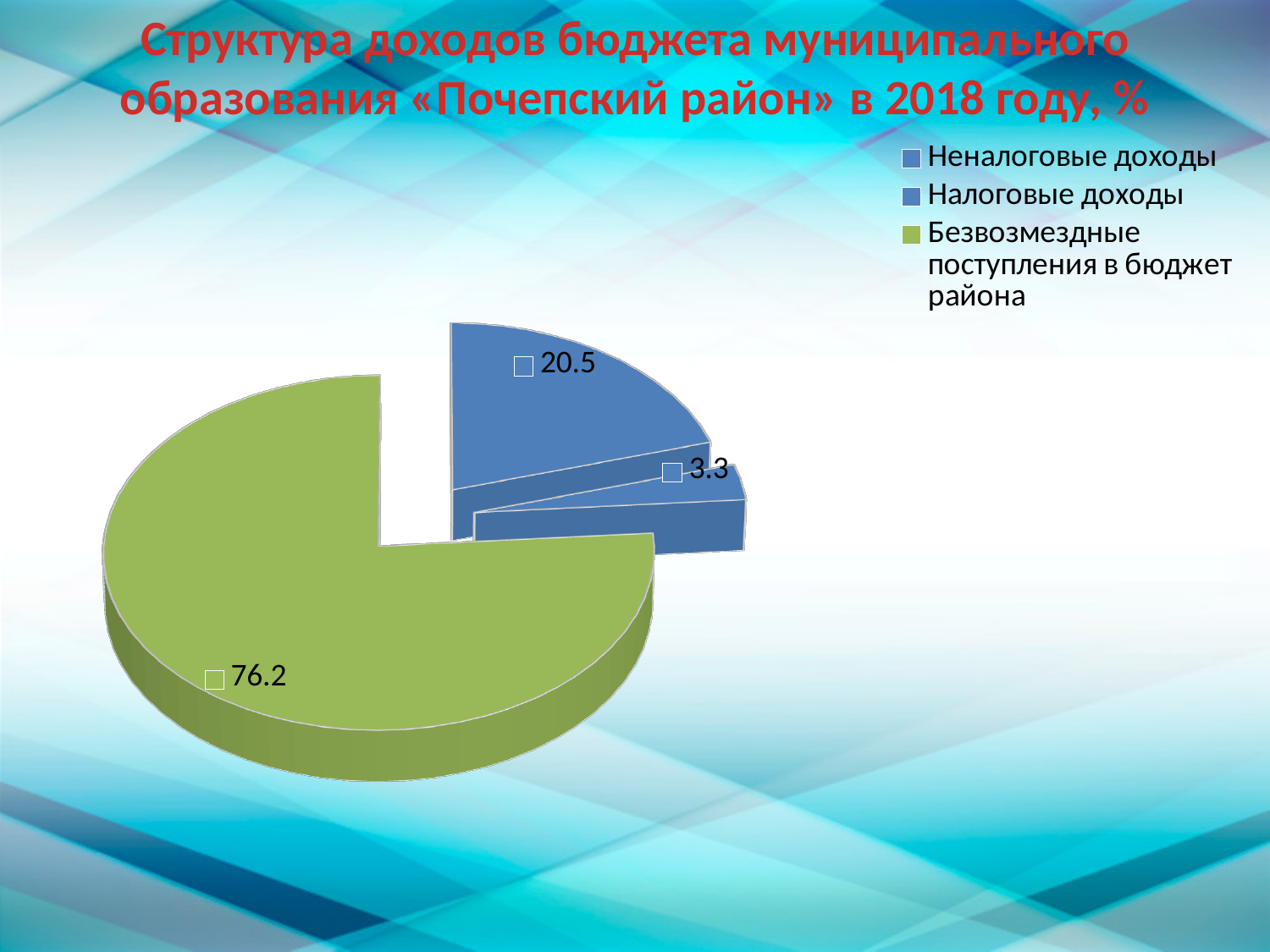
Which is larger, the slice labelled 20.5 or the slice labelled 3.3? 20.5 What is the smallest value labelled on the pie chart? 3.3 Which category has the largest share of the pie? Безвозмездные поступления в бюджет района What kind of chart is shown on the slide? pie chart How many entries does the legend list? 3 What is the difference between the largest slice (76.2) and the slice labelled 20.5? 55.7 What is the total of the three values labelled on the pie chart? 100 What colour is the slice for Безвозмездные поступления в бюджет района? green What is the value shown for Безвозмездные поступления в бюджет района? 76.2 What is the difference between the slices labelled 20.5 and 3.3? 17.2 How many slices does the pie chart have? 3 What is the largest value labelled on the pie chart? 76.2